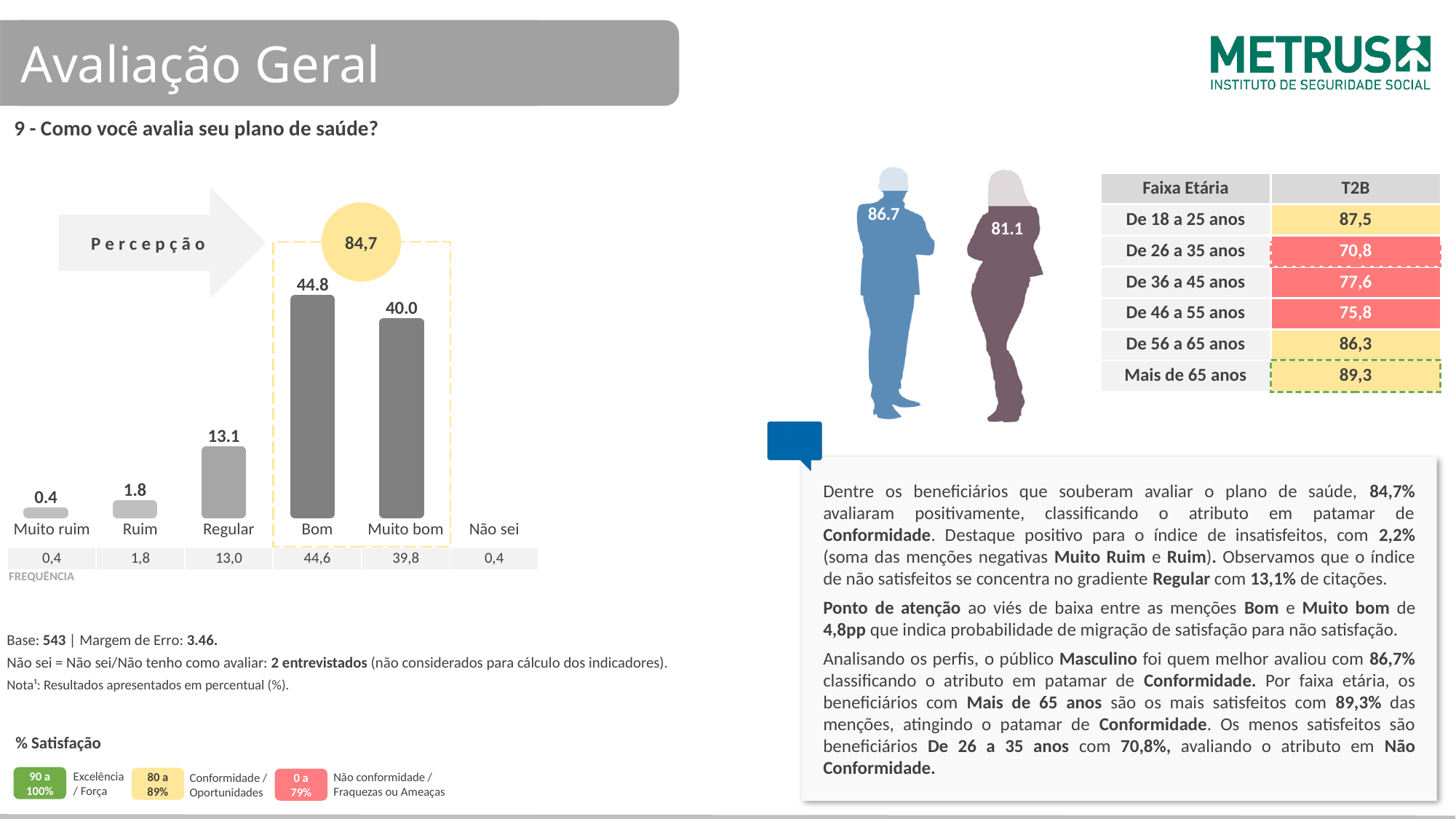
What is the difference between the 'Bom' and 'Muito bom' values in the chart? 4.8 How many categories are labeled along the x axis of the chart? 6 What is the difference between the 'Regular' and 'Ruim' values in the chart? 11.3 What is the value shown for the 'Muito ruim' bar in the chart? 0.4 Which category has the highest value in the chart? Bom Which is larger in the chart, the value for 'Ruim' or the value for 'Regular'? Regular What type of chart is shown on the slide? bar chart What is the value shown for the 'Regular' bar in the chart? 13.1 What value is shown in the yellow circle above the 'Bom' and 'Muito bom' bars? 84,7 What is the value shown for the 'Bom' bar in the chart? 44.8 Which category with a plotted bar has the lowest value in the chart? Muito ruim What is the value shown for the 'Muito bom' bar in the chart? 40.0